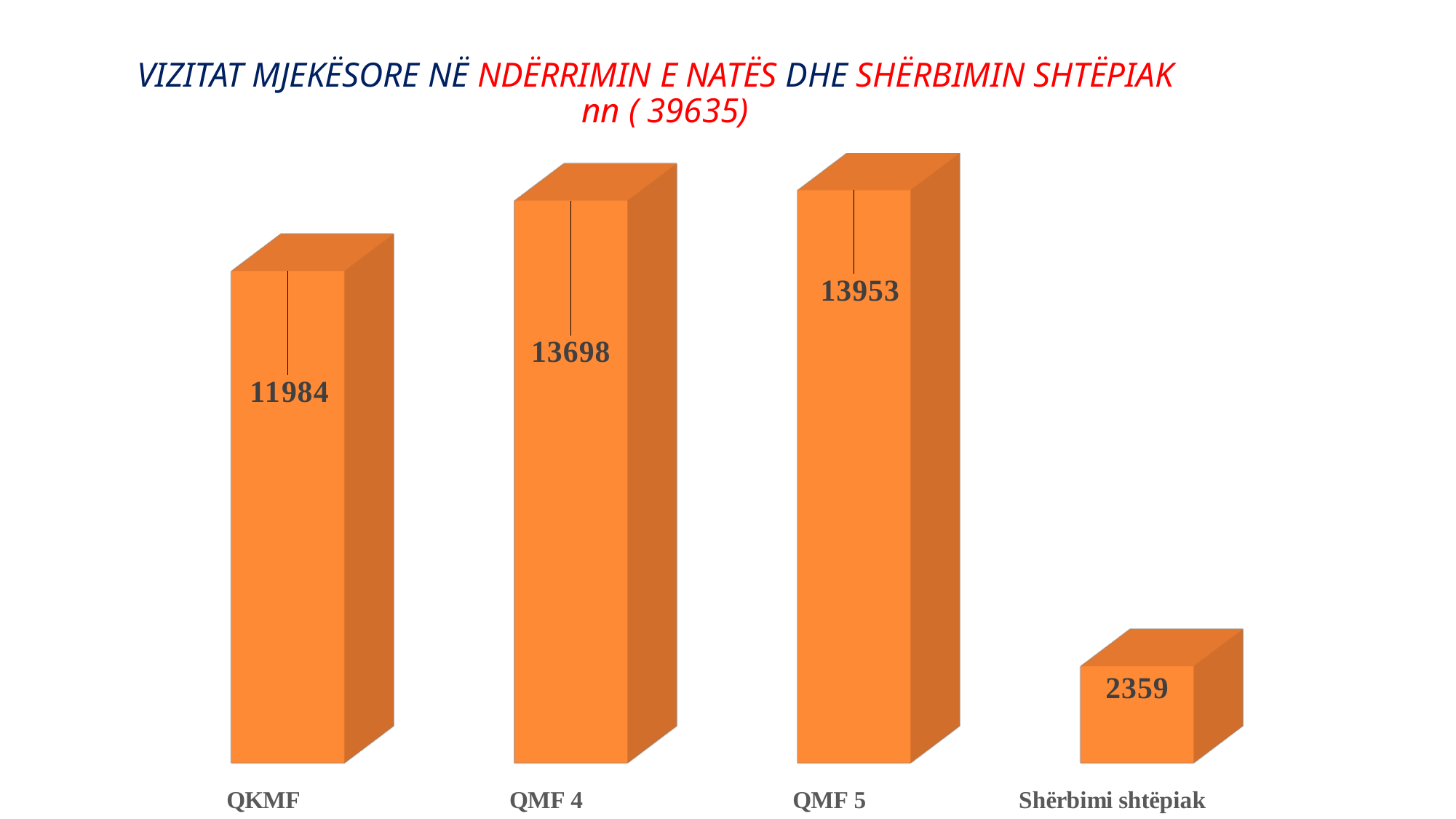
What is the value for QMF 4? 13698 What is the value for Shërbimi shtëpiak? 2359 How many categories are shown in the chart? 4 What kind of chart is shown on the slide? Bar chart What is the difference between the values for QMF 5 and QMF 4? 255 What is the difference between the values for QKMF and Shërbimi shtëpiak? 9625 What is the value for QMF 5? 13953 Which is larger, the value for QKMF or the value for QMF 4? QMF 4 Which category has the highest value? QMF 5 What is the value for QKMF? 11984 What total number is given in parentheses in the chart title? 39635 Which category has the lowest value? Shërbimi shtëpiak